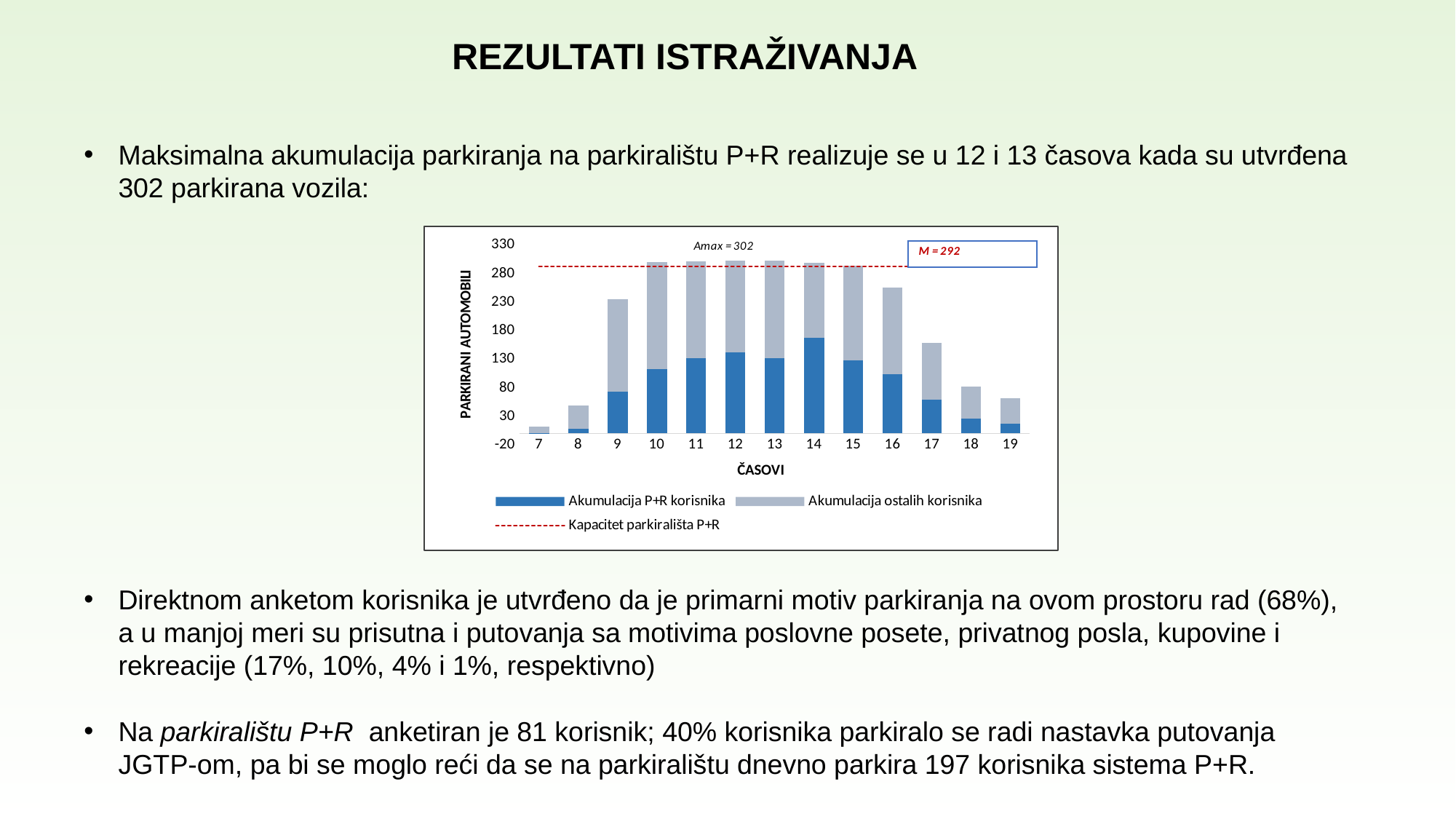
How many entries does the chart's legend list? 3 What maximum accumulation value (Amax) is annotated on the chart? 302 What kind of chart is shown on the slide? Stacked bar chart Is the Akumulacija P+R korisnika value at hour 14 greater or less than 130? greater Is the total stacked value at hour 9 greater or less than 180? greater What is the title of the x axis of the chart? ČASOVI Do the total stacked values rise or fall from hour 14 to hour 19? fall How many hours (categories) are shown on the x axis of the chart? 13 At which hour is the bar for Akumulacija P+R korisnika the highest? 14 What value of M is shown in the box on the chart? 292 Is the total stacked value at hour 18 greater or less than 130? less At which hour is the total stacked bar the lowest? 7